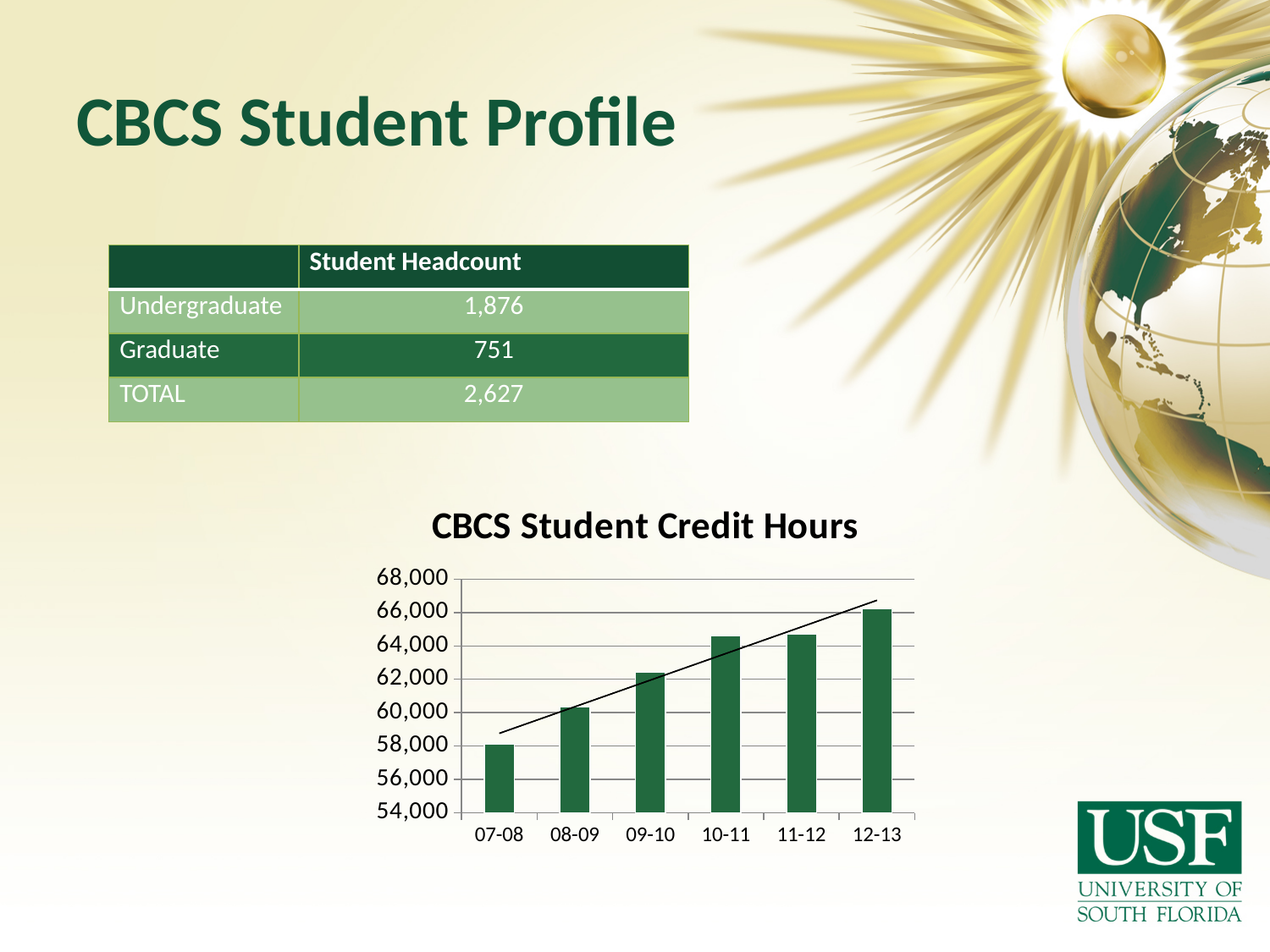
In the CBCS Student Credit Hours chart, is the value for 08-09 greater or less than 62,000? less In the CBCS Student Credit Hours chart, which year has more student credit hours, 07-08 or 09-10? 09-10 In the CBCS Student Credit Hours chart, is the value for 11-12 greater or less than 66,000? less What kind of chart is the CBCS Student Credit Hours chart? bar chart In the CBCS Student Credit Hours chart, is the value for 09-10 greater or less than 60,000? greater Do the student credit hours rise or fall from 07-08 to 12-13 in the CBCS Student Credit Hours chart? rise Which academic year has the lowest student credit hours in the CBCS Student Credit Hours chart? 07-08 What is the title of the chart on the slide? CBCS Student Credit Hours Which academic year has the highest student credit hours in the CBCS Student Credit Hours chart? 12-13 How many academic years are shown on the x axis of the CBCS Student Credit Hours chart? 6